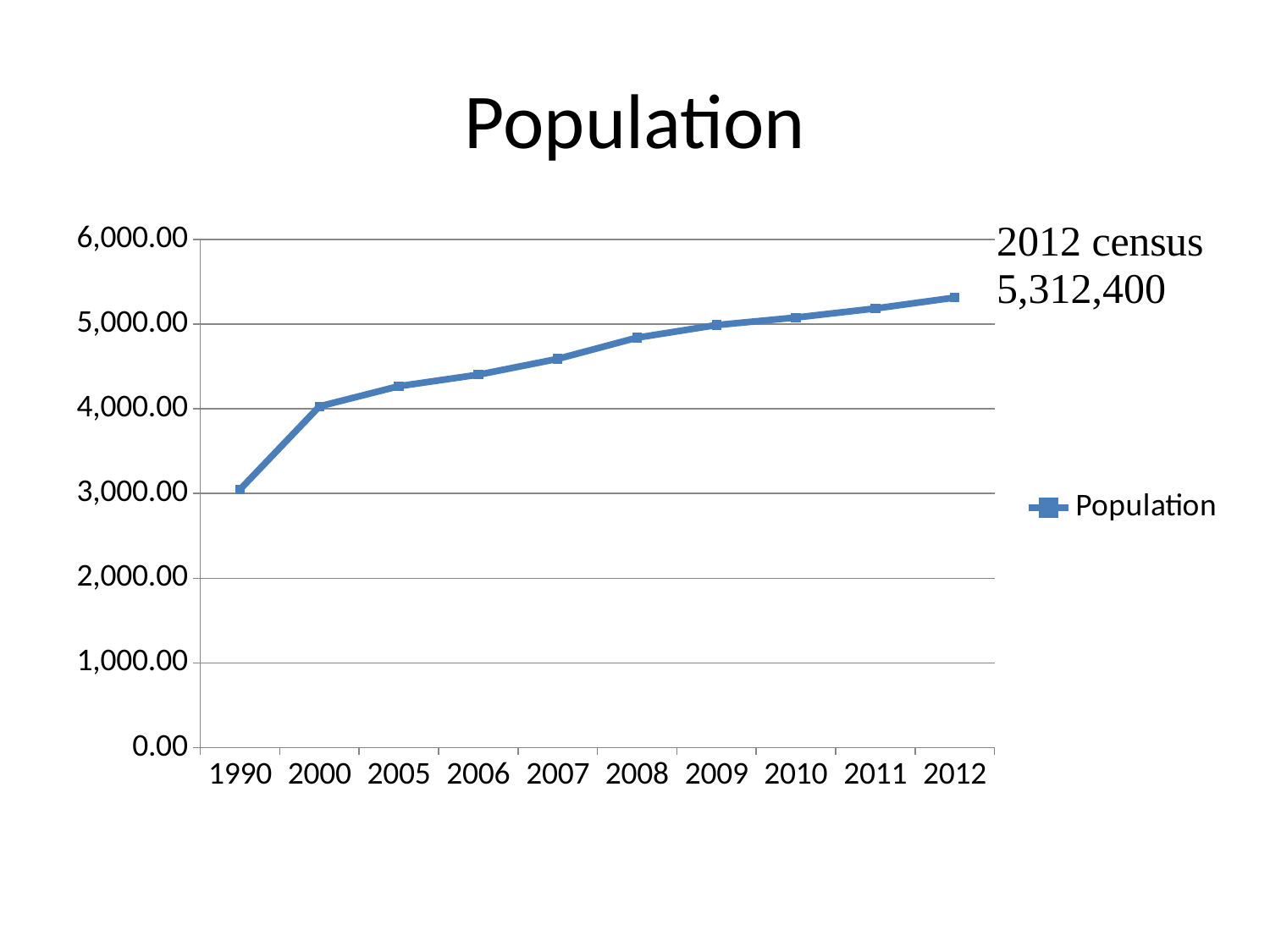
Which year has the highest population value? 2012 How many series does the legend list? 1 Which year has the lowest population value? 1990 What is the title of the chart? Population How many years are plotted along the x axis? 10 Do the population values rise or fall from 1990 to 2012? rise Is the population value for 1990 greater or less than 4,000.00? less Is the population value for 2005 greater or less than 4,000.00? greater Is the population value for 2012 greater or less than 5,000.00? greater What kind of chart is shown on the slide? line chart Which is larger, the population value for 2000 or for 2011? 2011